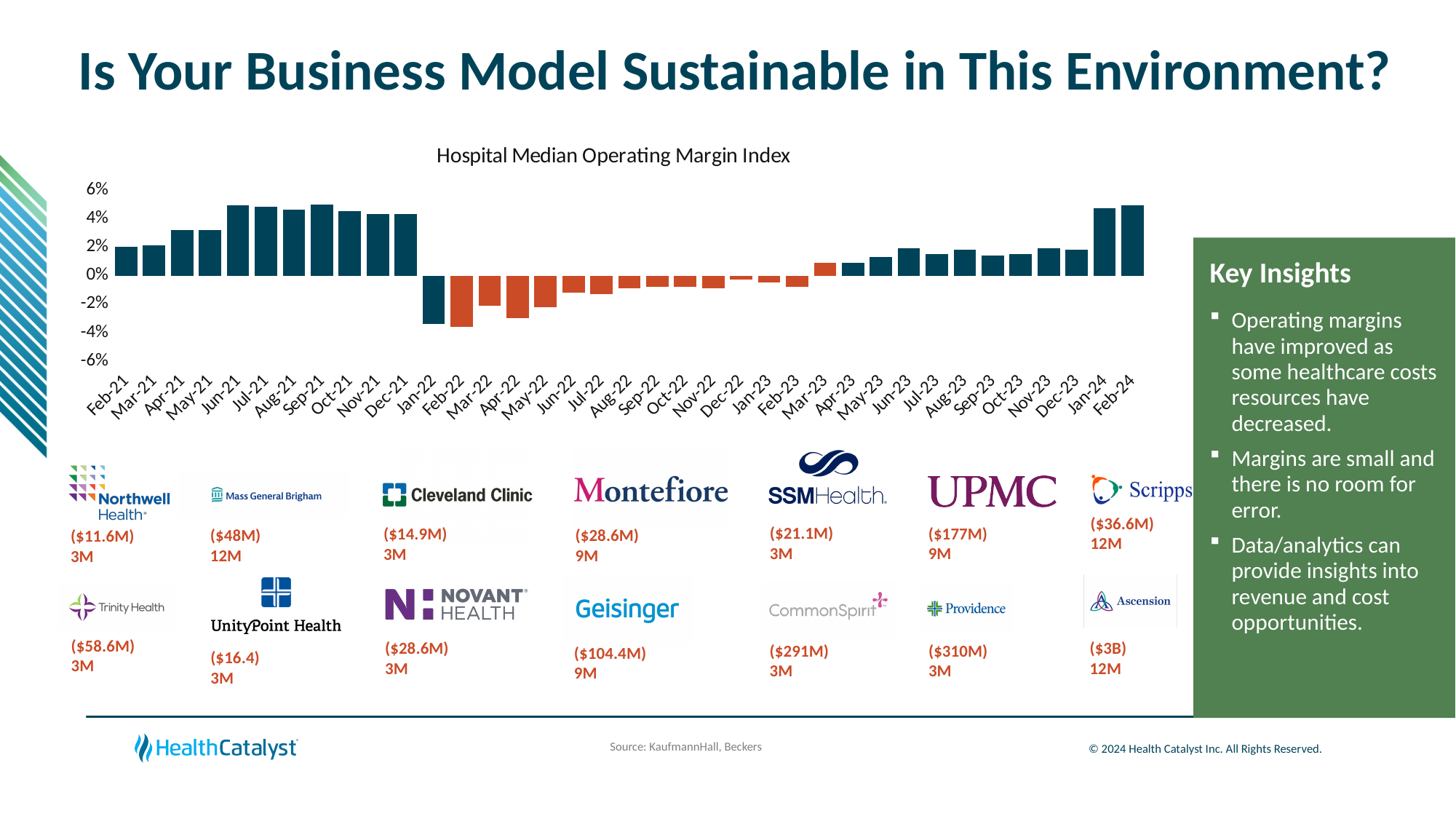
Which month is the first category on the x axis of the chart? Feb-21 What is the title of the chart? Hospital Median Operating Margin Index Which is larger, the value for Jun-21 or the value for Apr-21? Jun-21 Is the value for Feb-22 greater or less than -2%? less Is the value for Jan-24 greater or less than 4%? greater How many months are plotted on the x axis of the chart? 37 From Feb-22 to Feb-24, do the values generally rise or fall? rise Which is larger, the value for Jun-22 or the value for Feb-22? Jun-22 Is the value for Sep-21 greater or less than 4%? greater What kind of chart is used to show the Hospital Median Operating Margin Index? bar chart